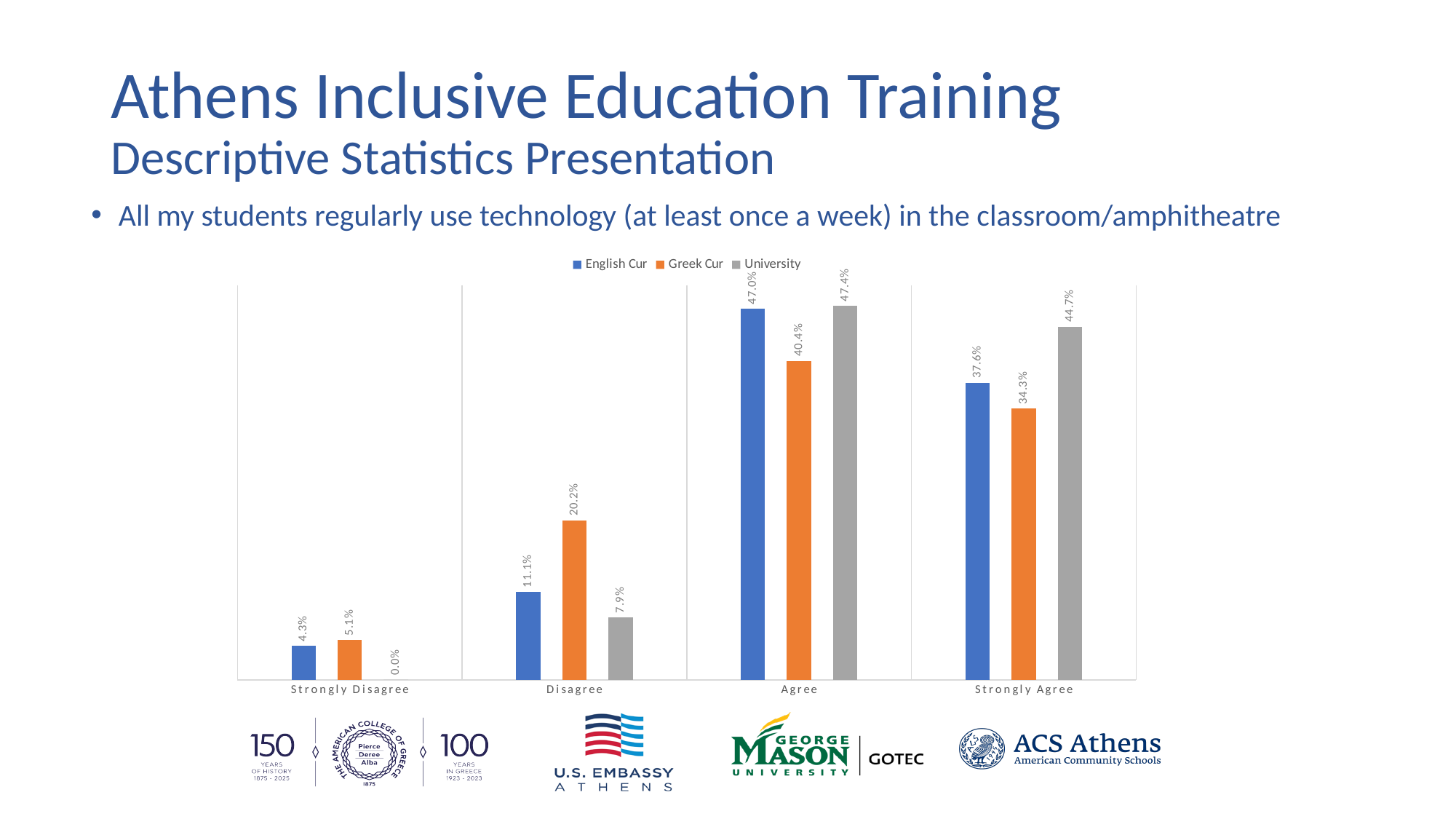
How many categories are shown on the x axis? 4 What is the value for University in the Strongly Disagree category? 0.0% Which category has the highest value for the Greek Cur series? Agree What is the value for University in the Strongly Agree category? 44.7% What kind of chart is shown on the slide? Bar chart What is the value for Greek Cur in the Disagree category? 20.2% What is the difference between the Greek Cur and University values in the Disagree category? 12.3% How many series does the legend list? 3 In the Strongly Agree category, which is larger: English Cur or Greek Cur? English Cur Which category has the lowest value for the English Cur series? Strongly Disagree What is the value for English Cur in the Agree category? 47.0% Which series is shown in orange in the legend? Greek Cur